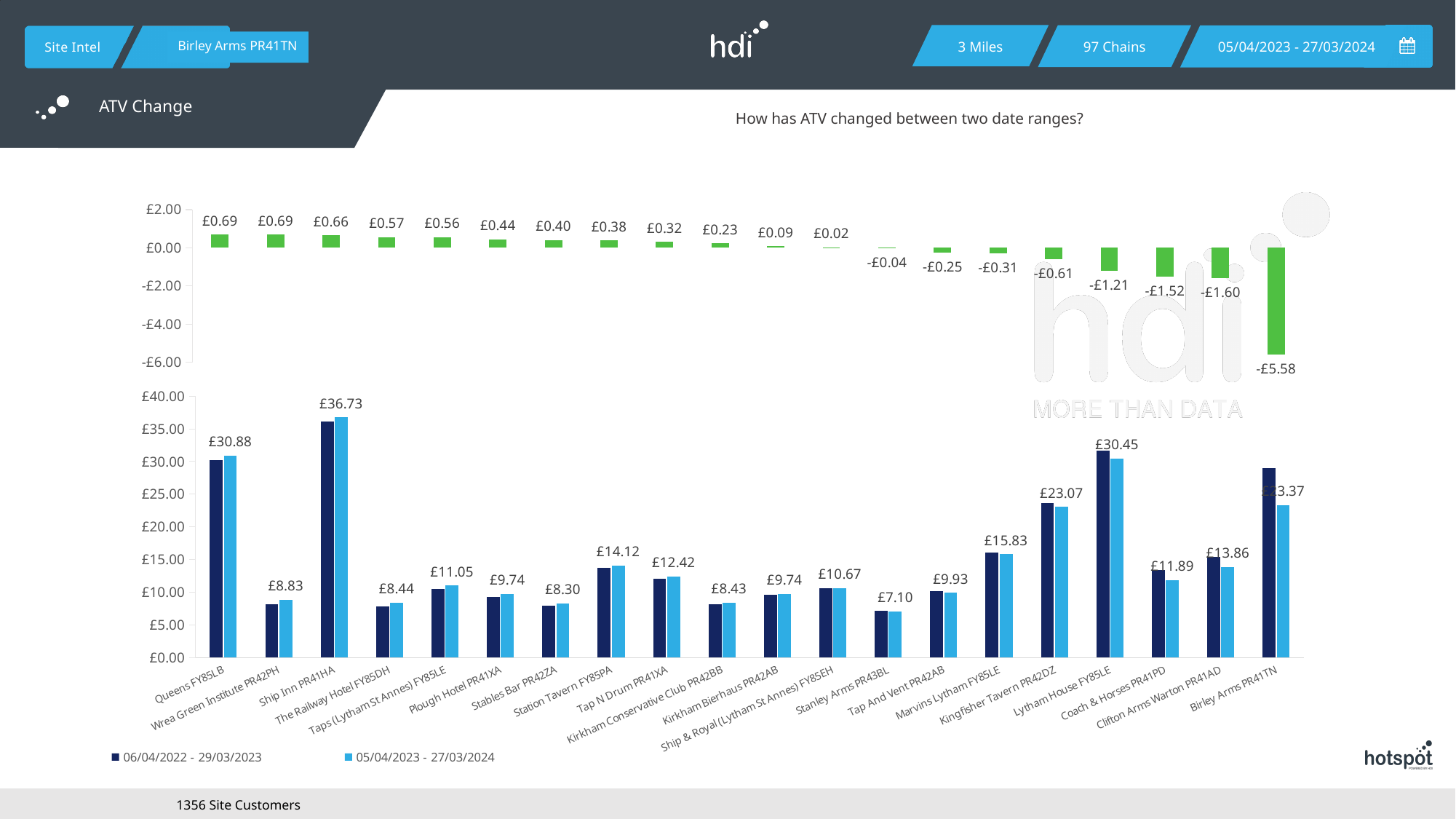
What kind of chart is the bottom chart? bar chart In the bottom chart, what is the ATV for Ship Inn PR41HA in the 05/04/2023 - 27/03/2024 period? £36.73 In the bottom chart, which site has the lowest ATV in the 05/04/2023 - 27/03/2024 period? Stanley Arms PR43BL How many sites are shown on the x axis of the bottom chart? 20 How many series does the legend of the bottom chart list? 2 In the bottom chart, is the 06/04/2022 - 29/03/2023 ATV for Birley Arms PR41TN greater or less than £25.00? greater In the bottom chart, what is the difference between the 05/04/2023 - 27/03/2024 ATV for Queens FY85LB (£30.88) and Lytham House FY85LE (£30.45)? £0.43 In the top chart, what is the ATV change shown for Birley Arms PR41TN? -£5.58 In the top chart, do the ATV change values rise or fall moving from left to right along the x axis? fall In the bottom chart, which site has the highest ATV in the 05/04/2023 - 27/03/2024 period? Ship Inn PR41HA In the top chart, which site has the lowest ATV change? Birley Arms PR41TN In the top chart, what is the ATV change shown for Lytham House FY85LE? -£1.21